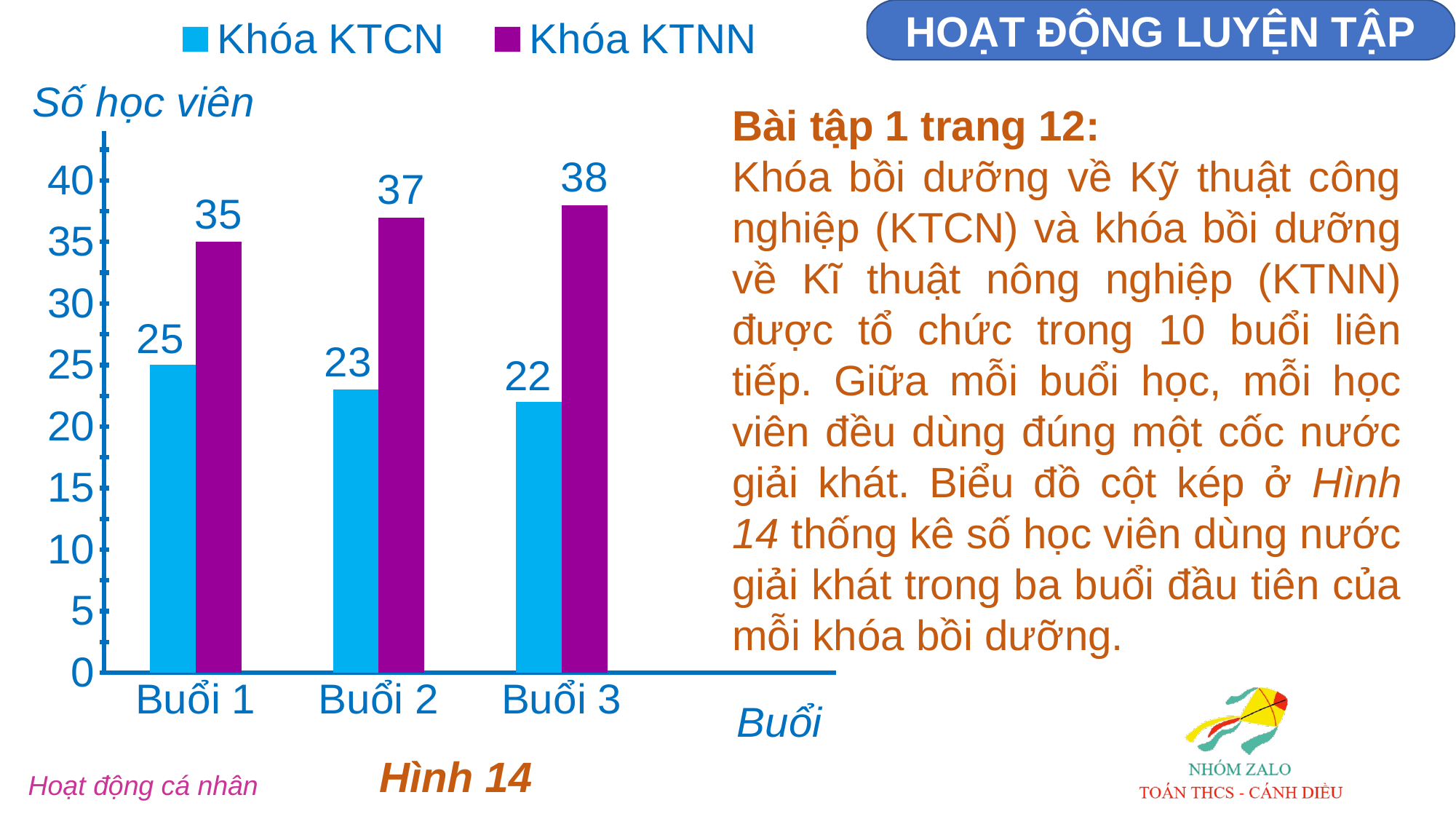
What kind of chart is shown? Bar chart What is the value for Khóa KTNN in Buổi 3? 38 What is the difference between Khóa KTNN in Buổi 3 and Khóa KTNN in Buổi 1? 3 How many series does the legend list? 2 What is the difference between Khóa KTNN and Khóa KTCN in Buổi 1? 10 Which is larger in Buổi 2: Khóa KTCN or Khóa KTNN? Khóa KTNN How many sessions (Buổi) are shown on the x axis? 3 Do the values for Khóa KTCN rise or fall from Buổi 1 to Buổi 3? Fall What is the value for Khóa KTCN in Buổi 1? 25 Which session (Buổi) has the highest value for Khóa KTNN? Buổi 3 Which session (Buổi) has the lowest value for Khóa KTCN? Buổi 3 What is the value for Khóa KTNN in Buổi 2? 37